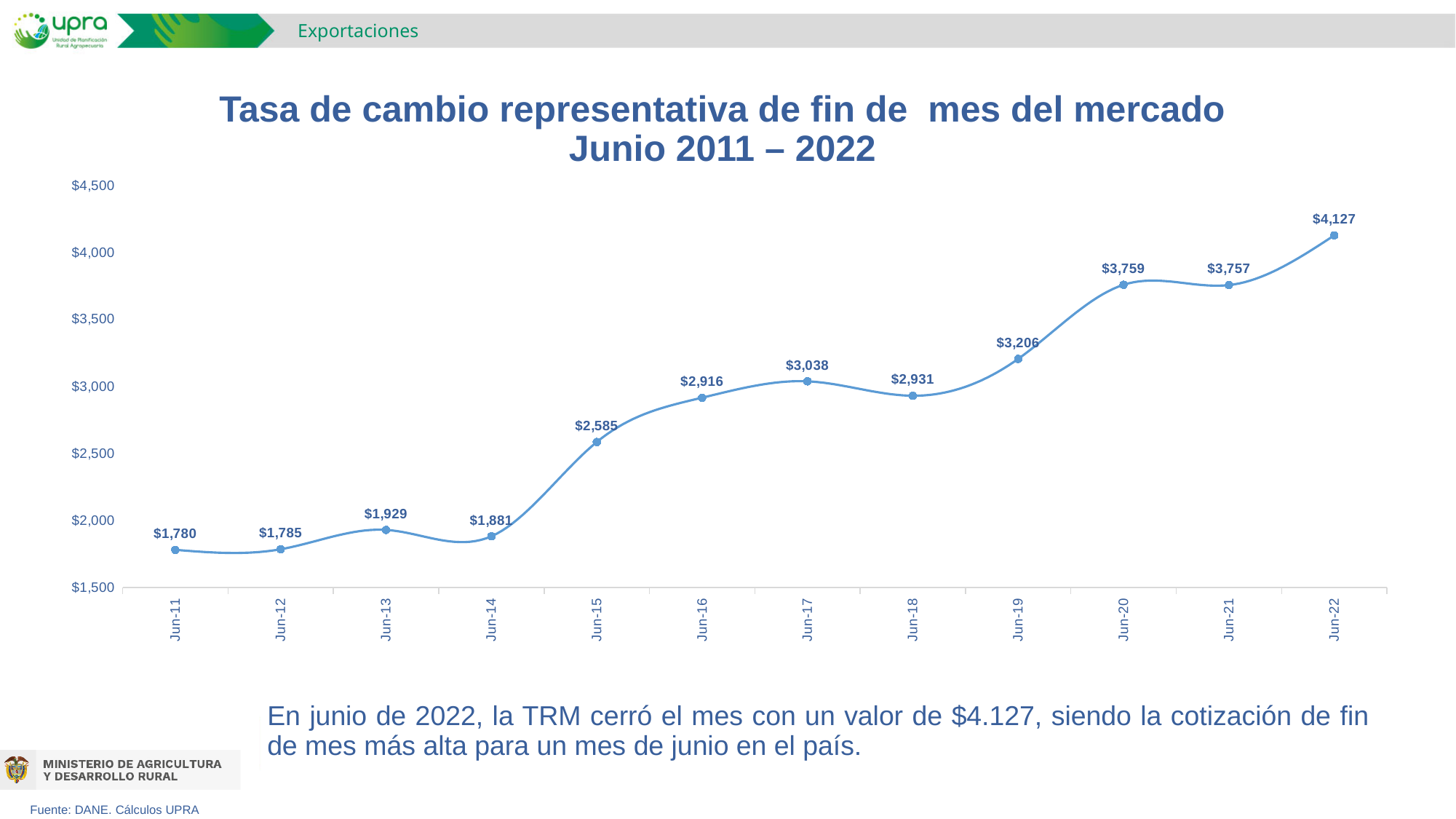
What is the value for Jun-22? $4,127 Do the values generally rise or fall from Jun-11 to Jun-22? rise How many data points are plotted on the chart? 12 What is the value for Jun-18? $2,931 Which is larger, the value for Jun-17 or the value for Jun-18? Jun-17 Is the value for Jun-19 greater or less than $3,000? greater What is the value for Jun-15? $2,585 Which point has the lowest value? Jun-11 Which point has the highest value? Jun-22 What kind of chart is shown on the slide? line chart What is the difference between the values for Jun-15 and Jun-14? $704 What is the difference between the values for Jun-22 and Jun-21? $370